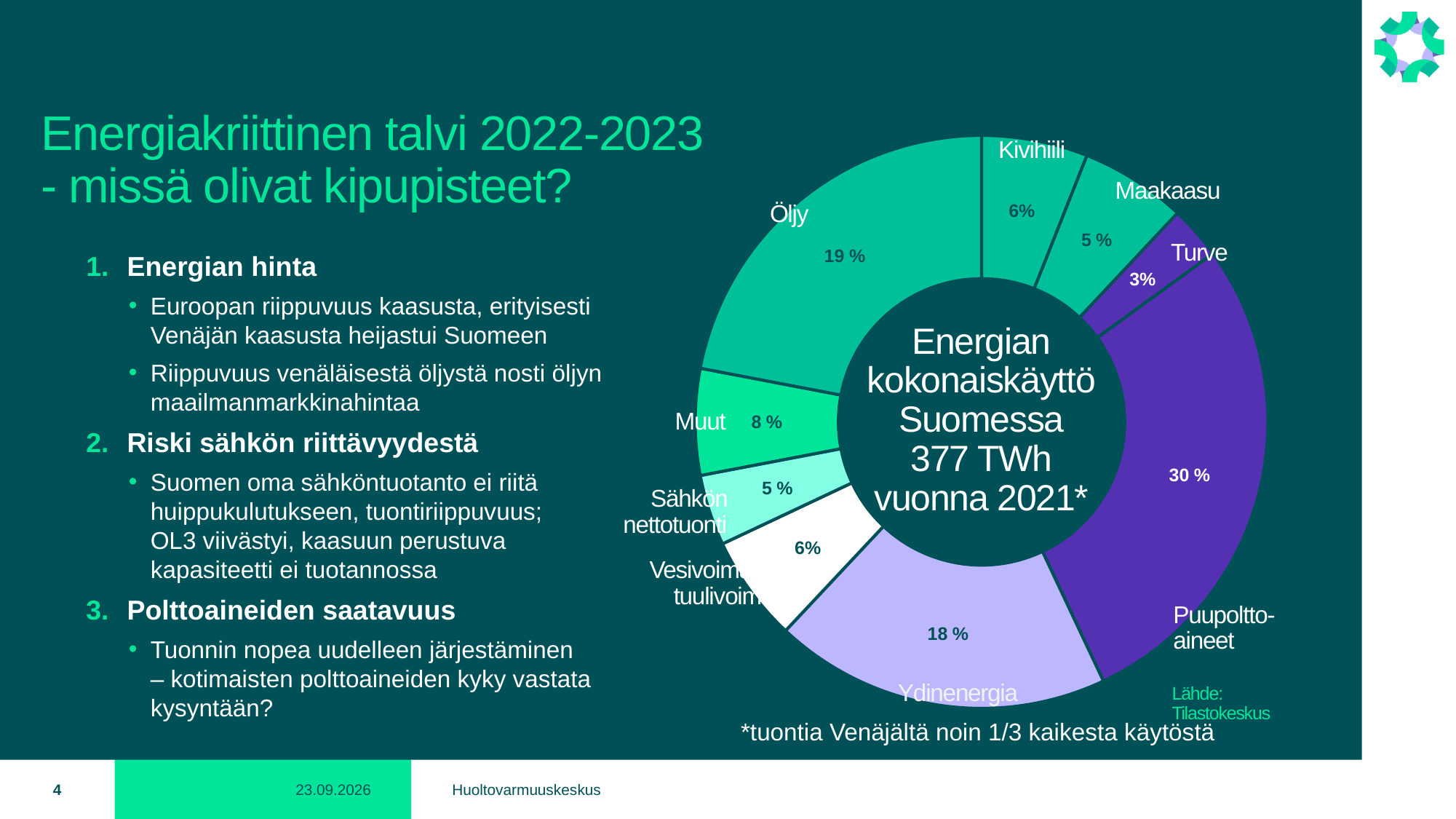
How many percentage points larger is the share of Puupolttoaineet than that of Ydinenergia? 12 What percentage is shown for Muut? 8 % What percentage is shown for Öljy? 19 % What percentage is shown for Ydinenergia? 18 % What percentage is shown for Turve? 3% Which has a larger share, Öljy or Kivihiili? Öljy Which category has the smallest share of the donut chart? Turve What kind of chart is shown on the slide? Donut (pie) chart Which category has the largest share of the donut chart? Puupolttoaineet What total energy use figure is printed in the centre of the donut chart? 377 TWh How many slices does the donut chart have? 9 What share of Finland's total energy use does Puupolttoaineet account for? 30 %